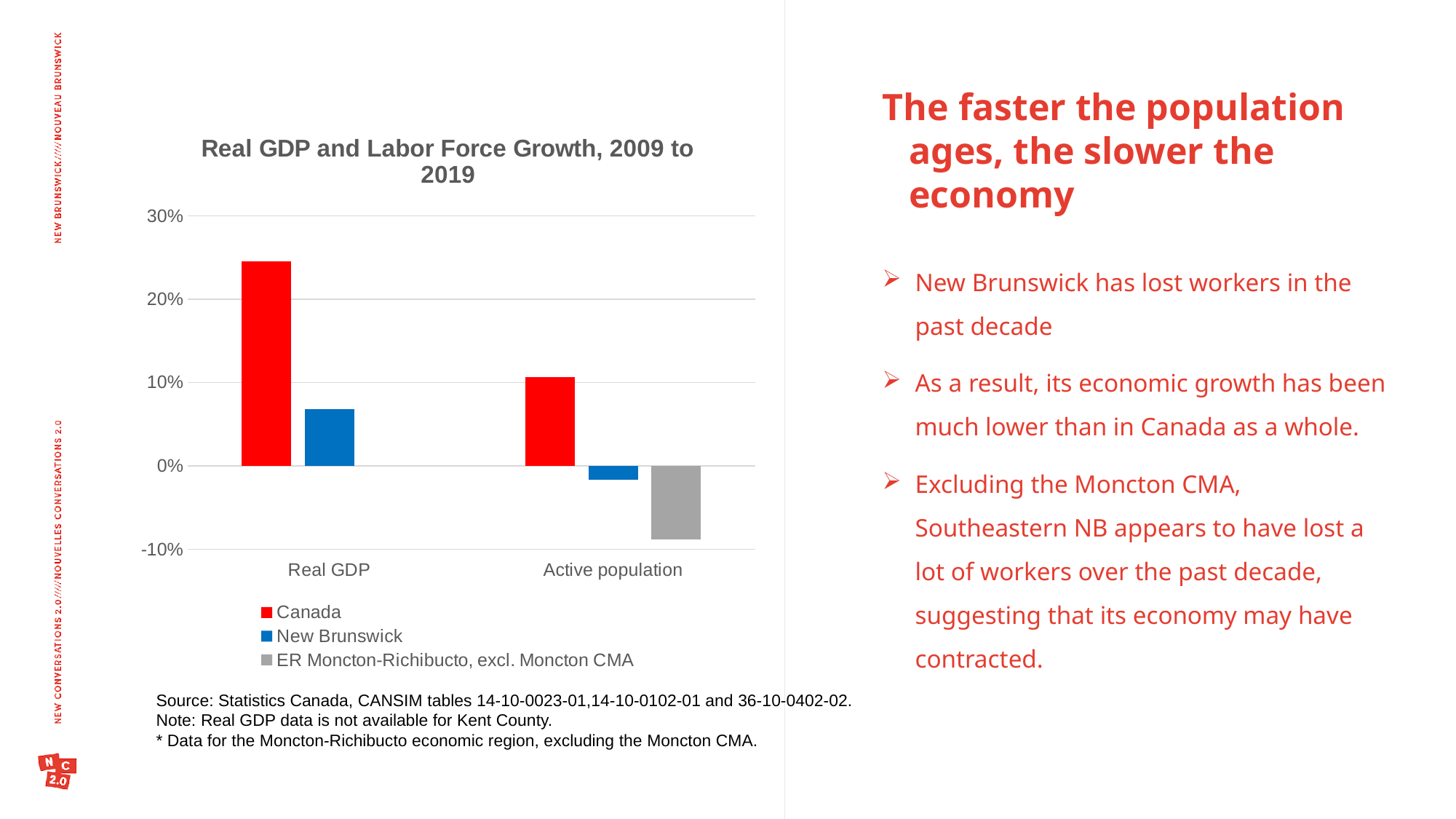
Which series is shown in grey in the legend? ER Moncton-Richibucto, excl. Moncton CMA Is the value for New Brunswick in Real GDP greater or less than 10%? less Is the value for Canada in Real GDP greater or less than 20%? greater How many series does the legend list? 3 What is the title of the chart? Real GDP and Labor Force Growth, 2009 to 2019 How many categories are shown on the x axis? 2 What kind of chart is shown on the slide? bar chart Which is larger for Real GDP, Canada or New Brunswick? Canada Which series has the lowest value in the Active population category? ER Moncton-Richibucto, excl. Moncton CMA Is the value for ER Moncton-Richibucto, excl. Moncton CMA in Active population greater or less than 0%? less Which bar is the highest in the whole chart? Canada, Real GDP